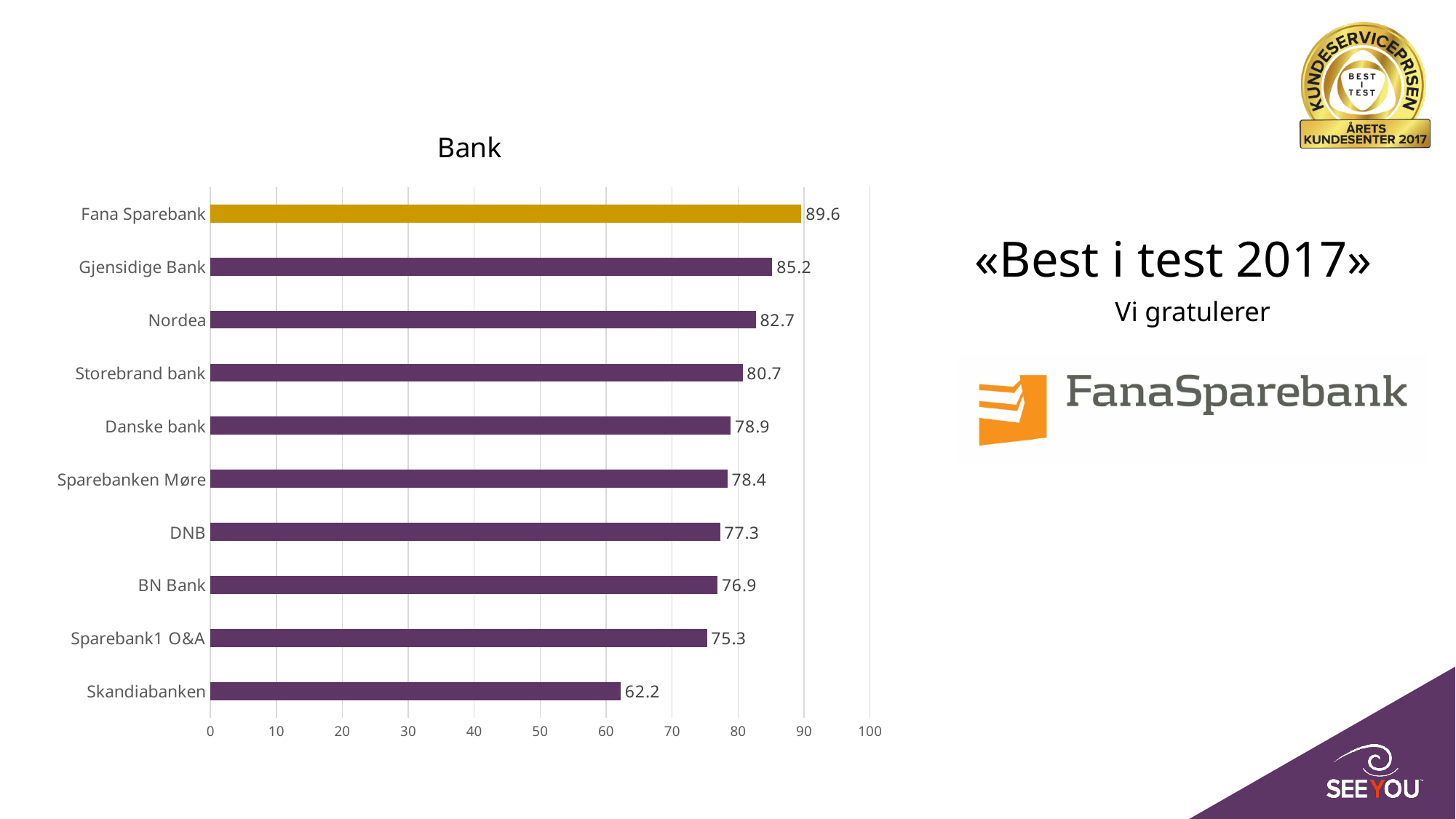
What is the difference between the values for Fana Sparebank and Gjensidige Bank? 4.4 Which bank has the lowest value? Skandiabanken Which bank has the highest value? Fana Sparebank What is the value for Nordea? 82.7 What kind of chart is shown on the slide? bar chart What is the title of the chart? Bank What is the value for DNB? 77.3 What is the value for Fana Sparebank? 89.6 Which has a larger value, Storebrand bank or Sparebank1 O&A? Storebrand bank What is the value for Skandiabanken? 62.2 How many banks are shown in the chart? 10 Is the value for Skandiabanken greater or less than 70? less